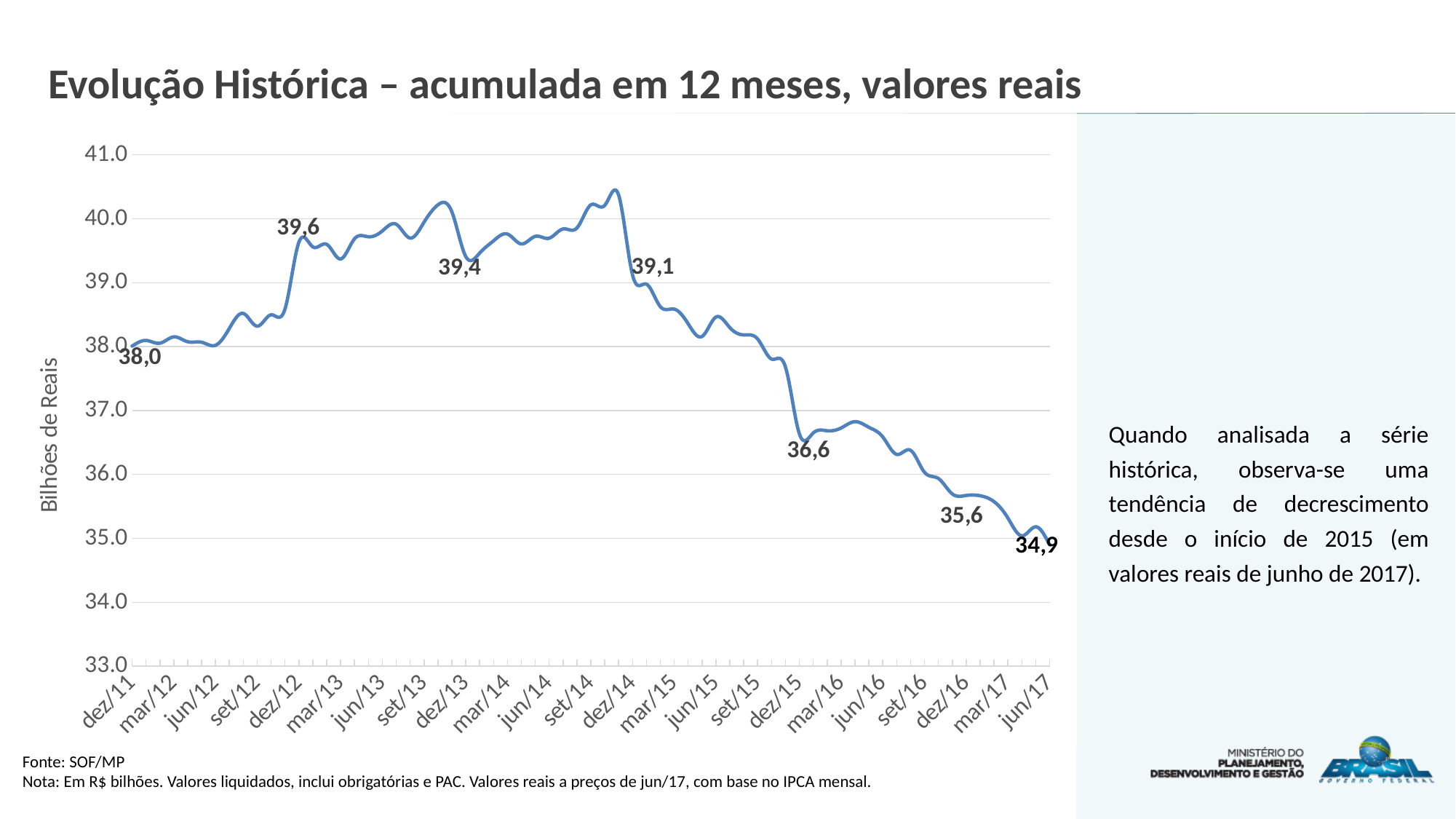
Does the line rise or fall from dez/14 to jun/17? fall What is the difference between the labelled values at dez/14 and dez/15? 2,5 Is the value at set/14 greater or less than 40.0? greater Which is larger, the labelled value at dez/13 or at dez/16? dez/13 What is the value labelled at dez/15? 36,6 What is the value labelled at dez/12? 39,6 What type of chart is shown on the slide? line chart What is the value labelled at dez/11? 38,0 What is the difference between the labelled values at dez/12 and jun/17? 4,7 What is the value labelled at jun/17? 34,9 Is the value at mar/16 greater or less than 37.0? less What is the label of the vertical axis? Bilhões de Reais